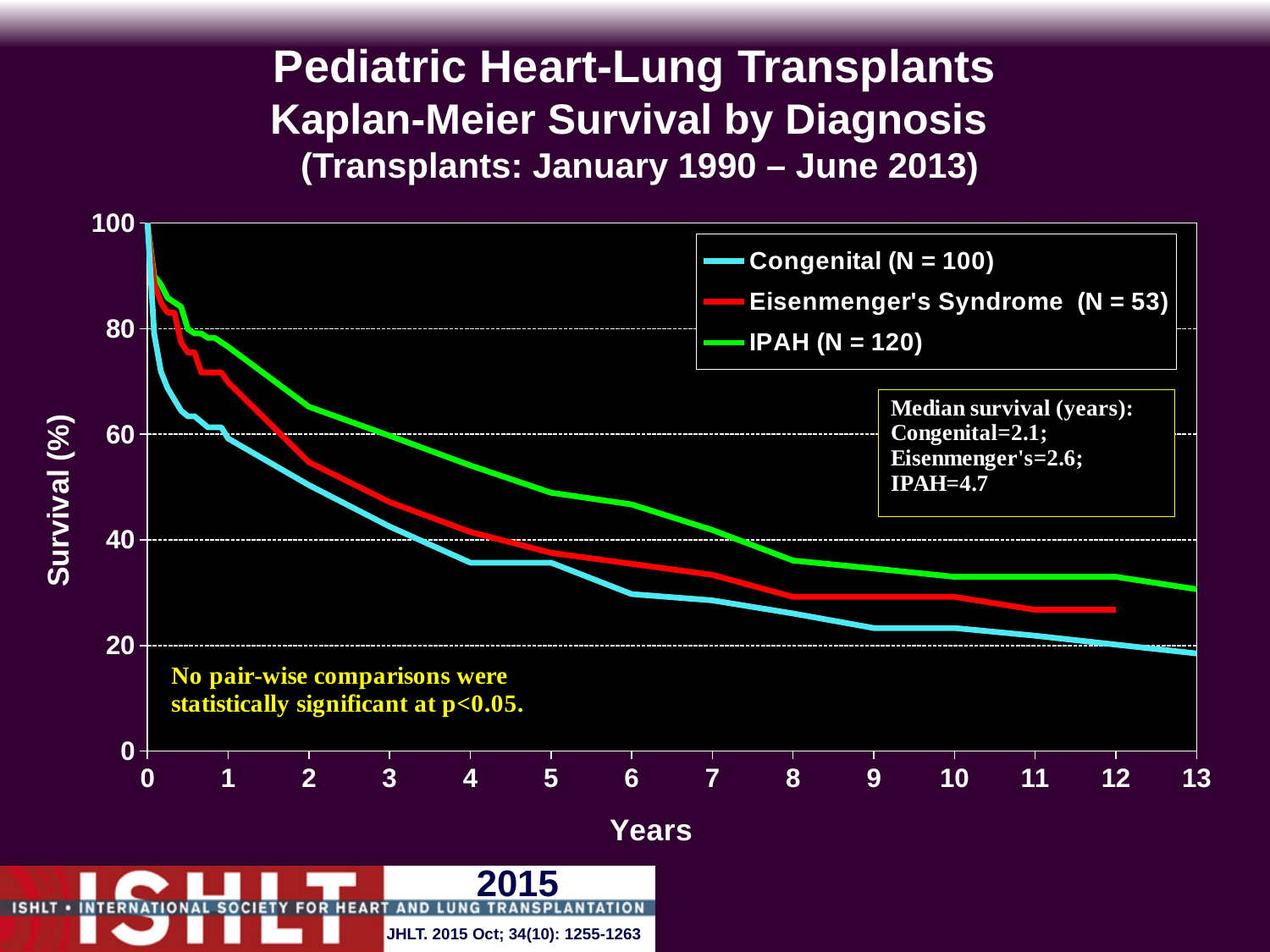
Which diagnosis group has the lowest median survival according to the text box? Congenital What is the median survival in years for the Eisenmenger's group, as stated in the text box? 2.6 Which diagnosis group has the highest median survival according to the text box? IPAH What is the median survival in years for the Congenital group, as stated in the text box? 2.1 What kind of chart is shown on the slide? line chart How many series does the legend list? 3 Is the survival for the IPAH group at 2 years greater or less than 60%? greater At 1 year, which group has higher survival: IPAH or Congenital? IPAH Is the survival for the Congenital group at 4 years greater or less than 40%? less What is the median survival in years for the IPAH group, as stated in the text box? 4.7 Do the survival curves rise or fall as years increase? fall How many patients (N) are in the Eisenmenger's Syndrome group according to the legend? 53